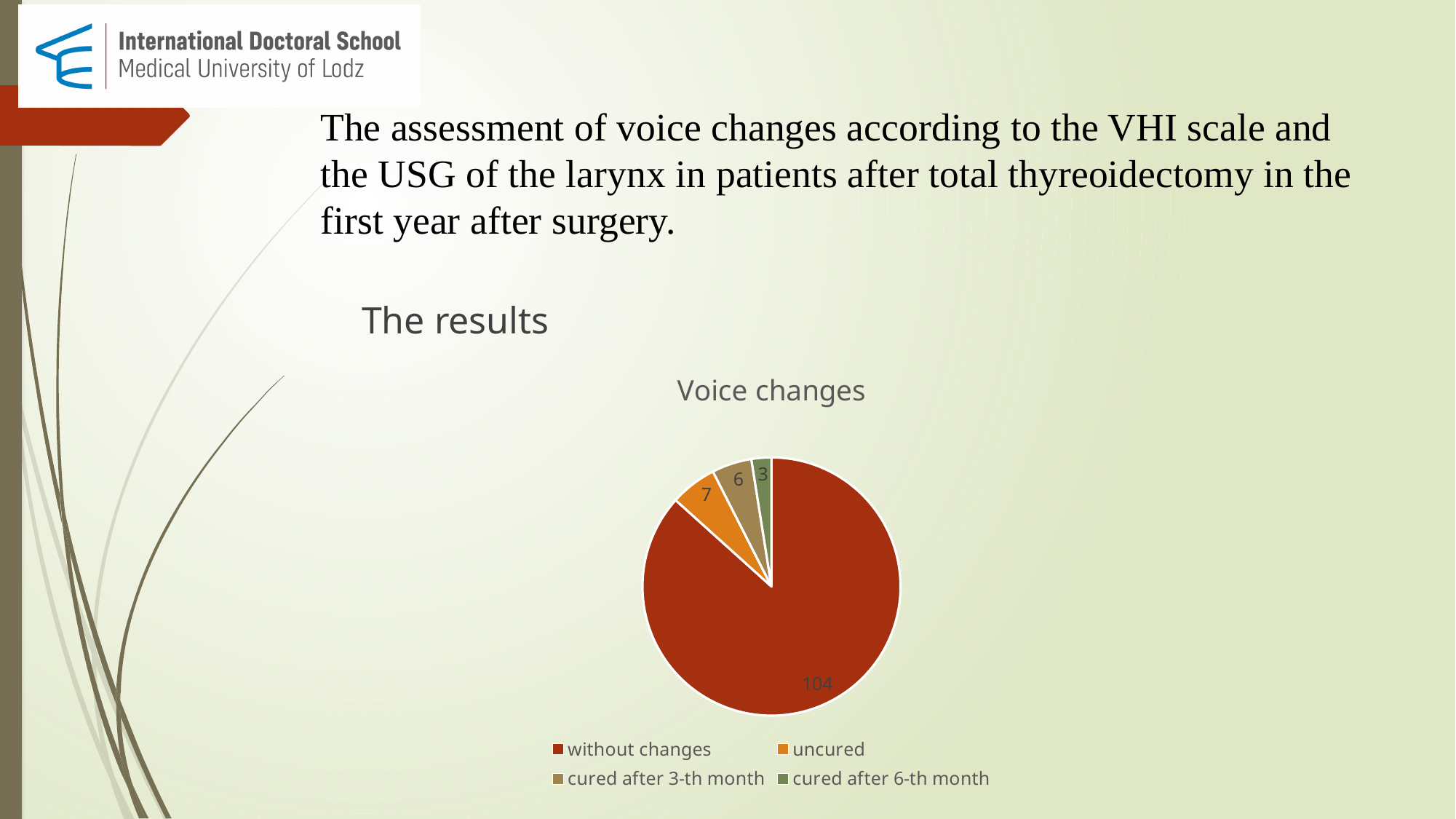
What is the total of all slices in the pie chart? 120 What type of chart is shown on the slide? pie chart What is the value for 'without changes'? 104 What is the title of the chart? Voice changes What is the difference between the 'without changes' value and the 'uncured' value? 97 Which is larger, 'uncured' or 'cured after 3-th month'? uncured What is the value for 'cured after 6-th month'? 3 How many slices does the pie chart have? 4 Which category has the smallest slice? cured after 6-th month What is the value for 'cured after 3-th month'? 6 Which category has the largest slice? without changes What is the value for 'uncured'? 7